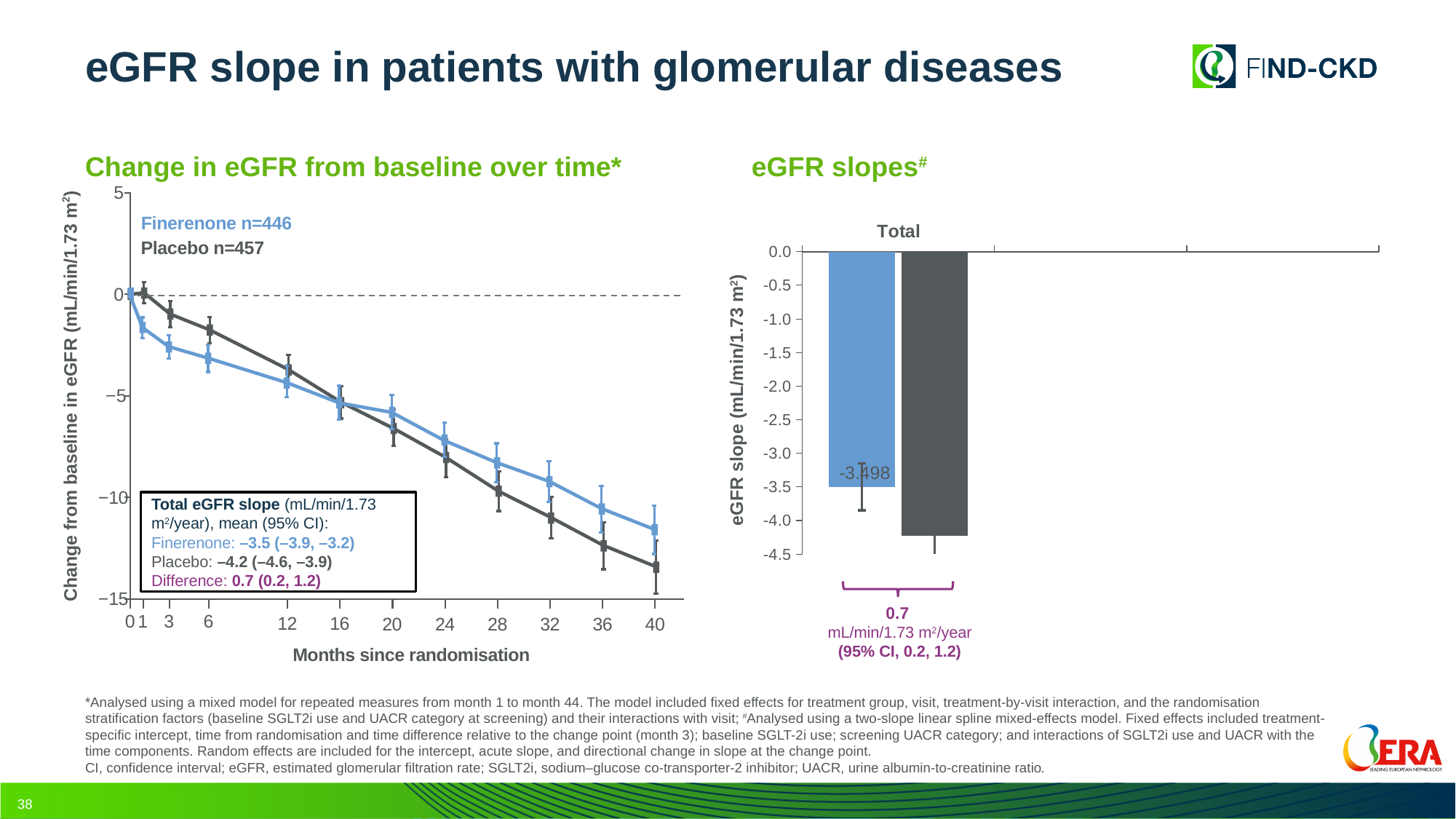
In the right chart 'eGFR slopes#', is the value of the blue bar greater or less than -3.0? less In the left chart 'Change in eGFR from baseline over time*', at month 40 is the Finerenone value greater or less than -10? less What is the x-axis label of the left chart 'Change in eGFR from baseline over time*'? Months since randomisation In the left chart 'Change in eGFR from baseline over time*', how many series are plotted? 2 What kind of chart is the left chart titled 'Change in eGFR from baseline over time*'? line chart What kind of chart is the right chart titled 'eGFR slopes#'? bar chart In the right chart 'eGFR slopes#', what category label is shown above the bars? Total In the left chart 'Change in eGFR from baseline over time*', at month 40 which series has the lower value, Finerenone or Placebo? Placebo In the right chart 'eGFR slopes#', is the value of the dark grey bar greater or less than -4.0? less In the left chart 'Change in eGFR from baseline over time*', do the values rise or fall as months since randomisation increase? fall In the right chart 'eGFR slopes#', what value is printed on the blue bar? -3.498 In the right chart 'eGFR slopes#', which bar extends further below zero, the blue bar or the dark grey bar? the dark grey bar